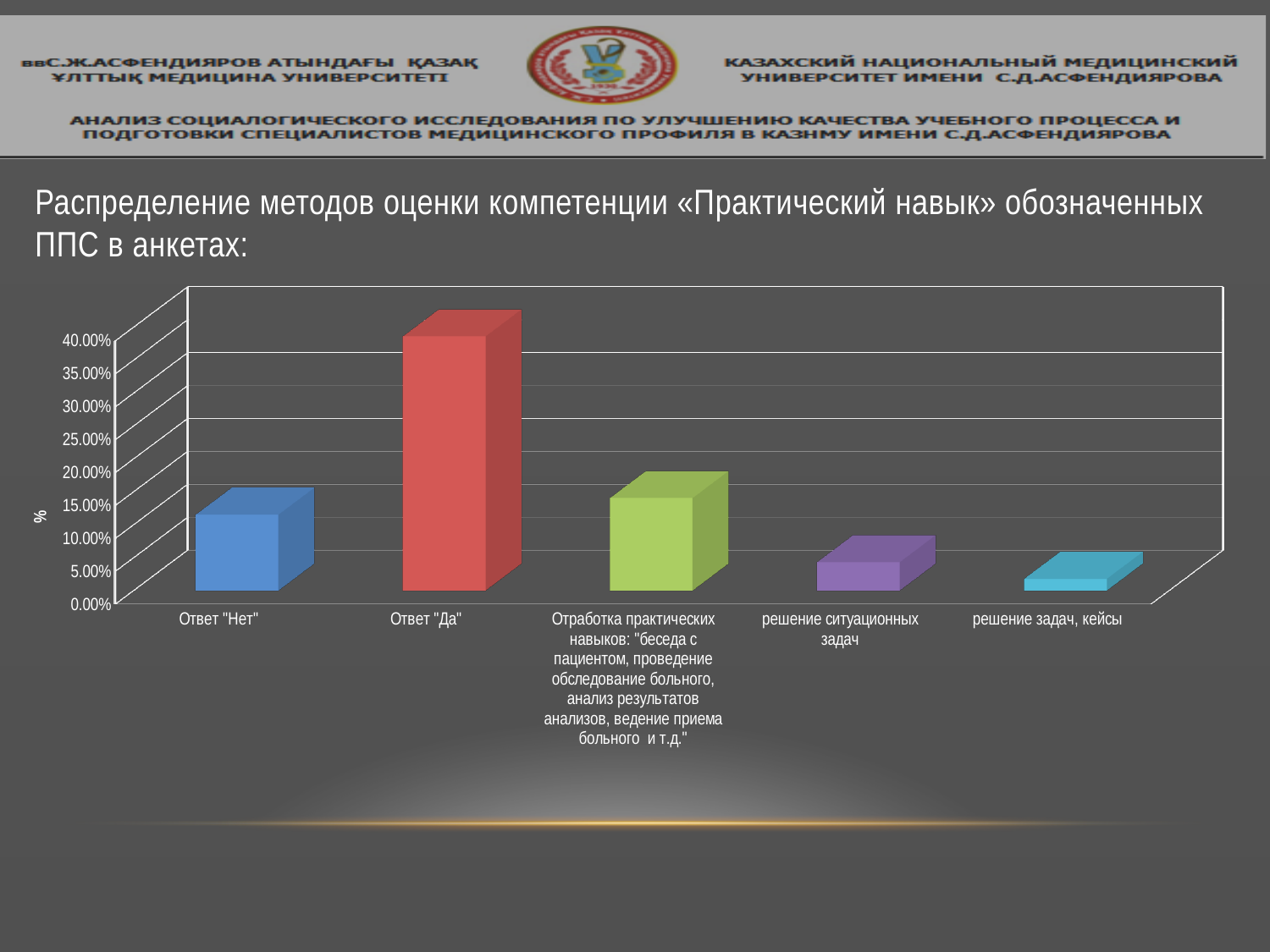
Which is larger, the value for Ответ "Да" or the value for Ответ "Нет"? Ответ "Да" What kind of chart is shown on the slide? bar chart Is the value for решение задач, кейсы greater or less than 10.00%? less How many categories are plotted on the chart? 5 Which is larger, the value for решение ситуационных задач or the value for решение задач, кейсы? решение ситуационных задач What is the highest tick value shown on the vertical axis? 40.00% Which category has the highest value on the chart? Ответ "Да" Is the value for решение ситуационных задач greater or less than 10.00%? less What is the label on the vertical axis of the chart? % Which category has the lowest value on the chart? решение задач, кейсы Is the value for Ответ "Нет" greater or less than 20.00%? less